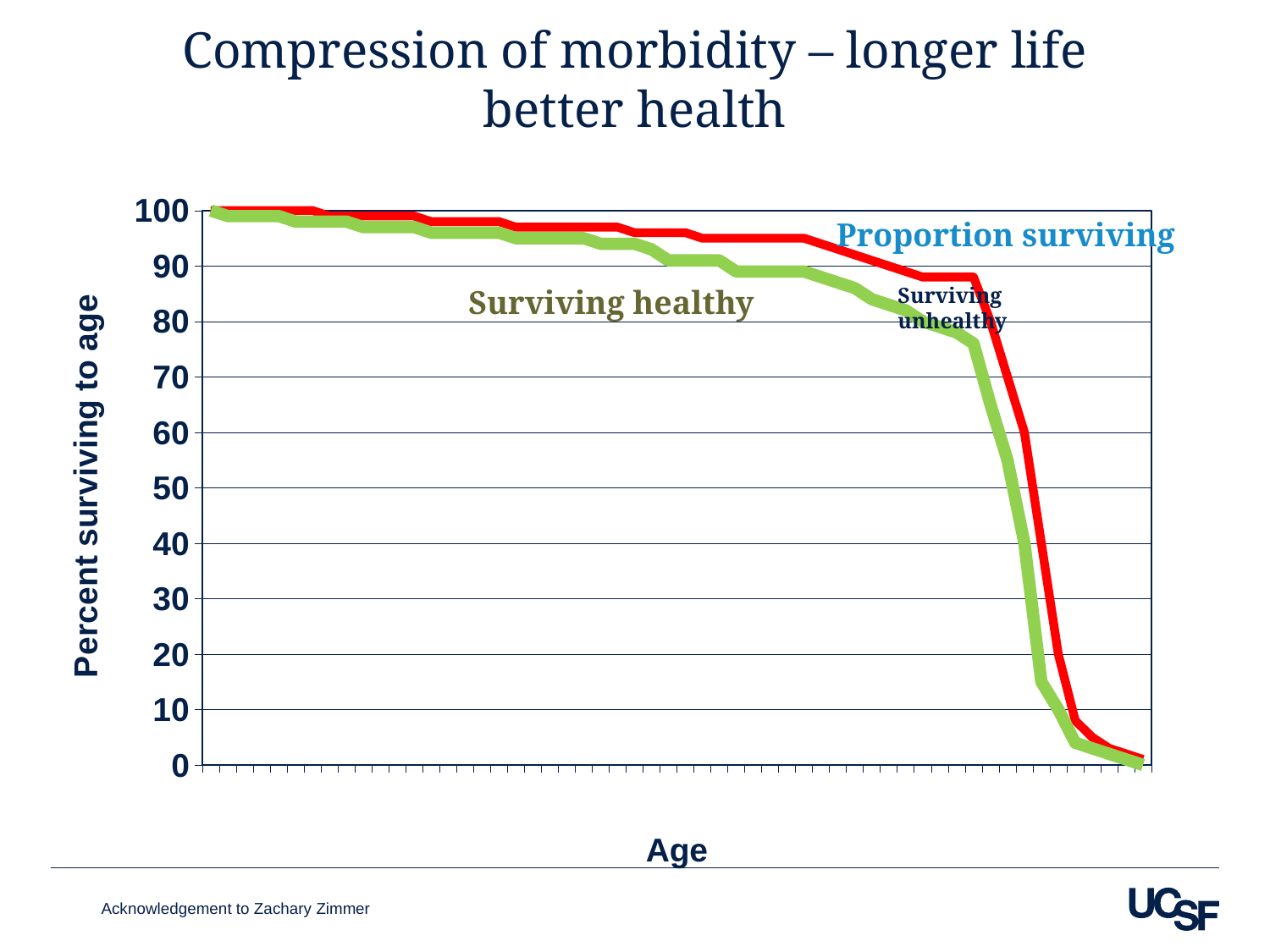
Do the plotted values rise or fall as age increases along the x axis? fall What is the label of the horizontal axis? Age Is the starting value of the Proportion surviving line greater or less than 90? greater How many lines are plotted on the chart? 2 What kind of chart is shown on the slide? line chart Is the final value of the Surviving healthy line greater or less than 10? less What is the highest value shown on the vertical axis? 100 What is the lowest value shown on the vertical axis? 0 Which line is higher across the chart, Proportion surviving or Surviving healthy? Proportion surviving Which line reaches a lower value at the right end of the chart, the red line or the green line? the green line What is the label of the vertical axis? Percent surviving to age